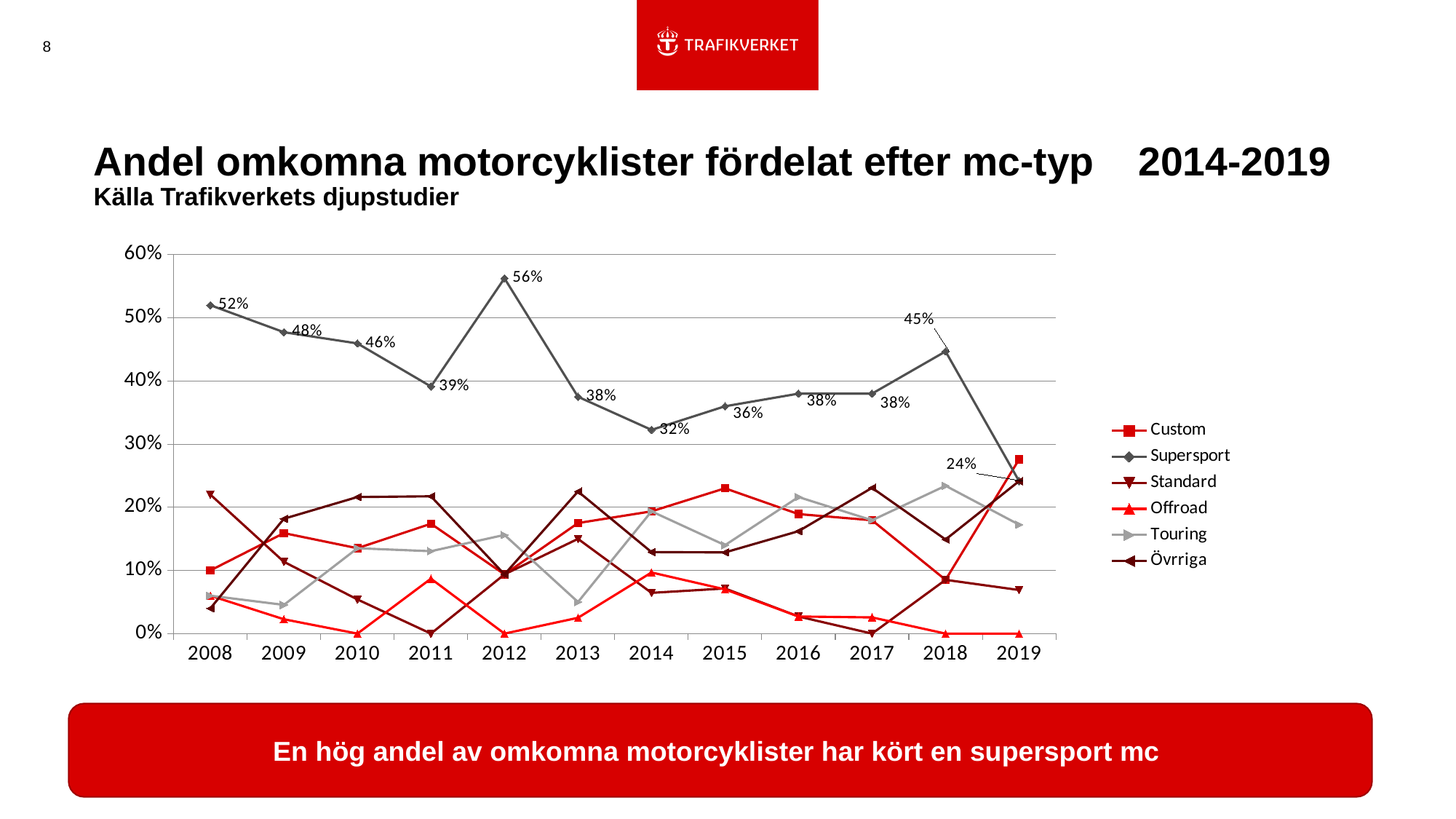
Which is larger, the Supersport value for 2011 or for 2014? 2011 Does the Supersport value rise or fall from 2008 to 2011? fall What is the Supersport value for 2008? 52% What type of chart is shown on the slide? line chart How many years are shown on the x axis? 12 What is the Supersport value for 2019? 24% In which year is the Supersport value lowest? 2019 In which year is the Supersport value highest? 2012 What is the Supersport value for 2012? 56% Is the Custom value for 2019 greater or less than 20%? greater How many series does the legend list? 6 What is the difference between the Supersport values for 2018 and 2019? 21%